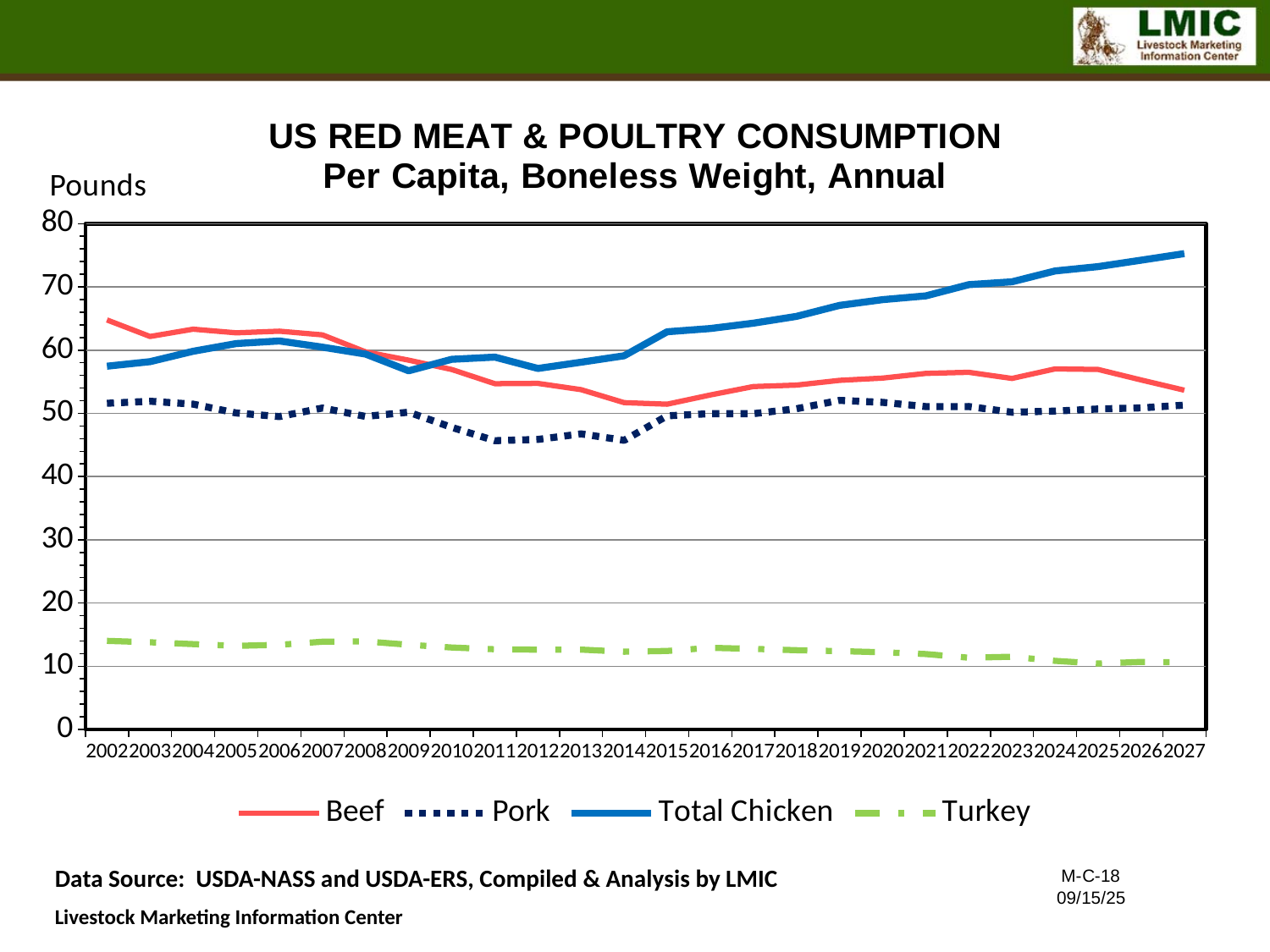
Is the value for Beef in 2002 greater or less than 60? greater How many years are plotted along the x axis? 26 How many series does the legend list? 4 Is the value for Pork in 2011 greater or less than 50? less In 2002, which is larger, Beef or Total Chicken? Beef Is the value for Total Chicken in 2027 greater or less than 70? greater Which series has the lowest value in 2027? Turkey Which series has the highest value in 2027? Total Chicken Does the Turkey line generally rise or fall from 2002 to 2027? fall What unit is shown on the y axis label? Pounds Does the Total Chicken line generally rise or fall from 2002 to 2027? rise What kind of chart is shown on the slide? line chart